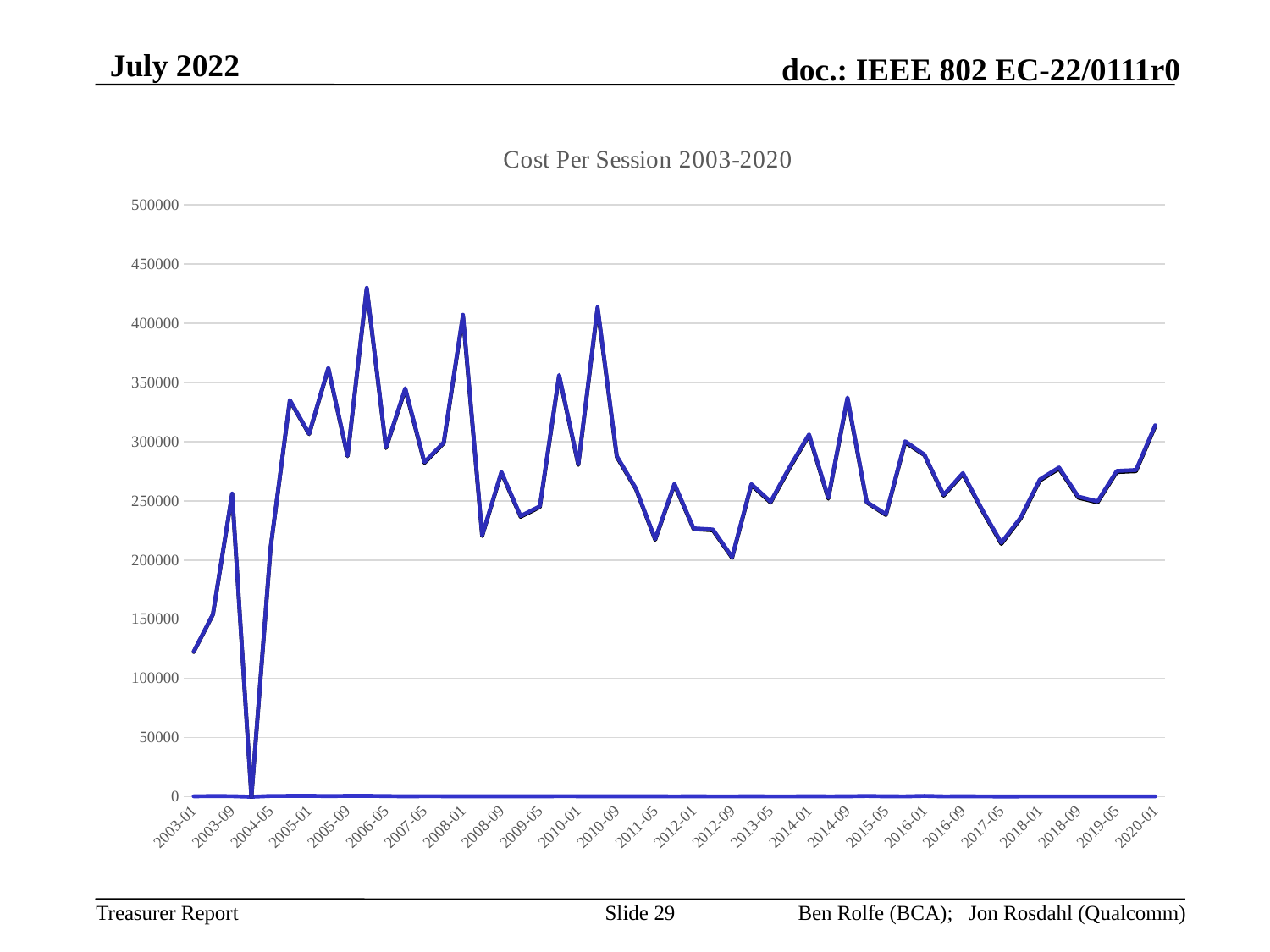
What is the title of the chart? Cost Per Session 2003-2020 Is the value for 2005-01 greater or less than 250000? greater Is the value for 2003-01 greater or less than 150000? less Is the value for 2003-09 greater or less than 200000? greater What is the highest value shown on the vertical axis? 500000 What kind of chart is shown on the slide? line chart Which has the larger value, 2012-09 or 2014-09? 2014-09 Which has the larger value, 2003-01 or 2020-01? 2020-01